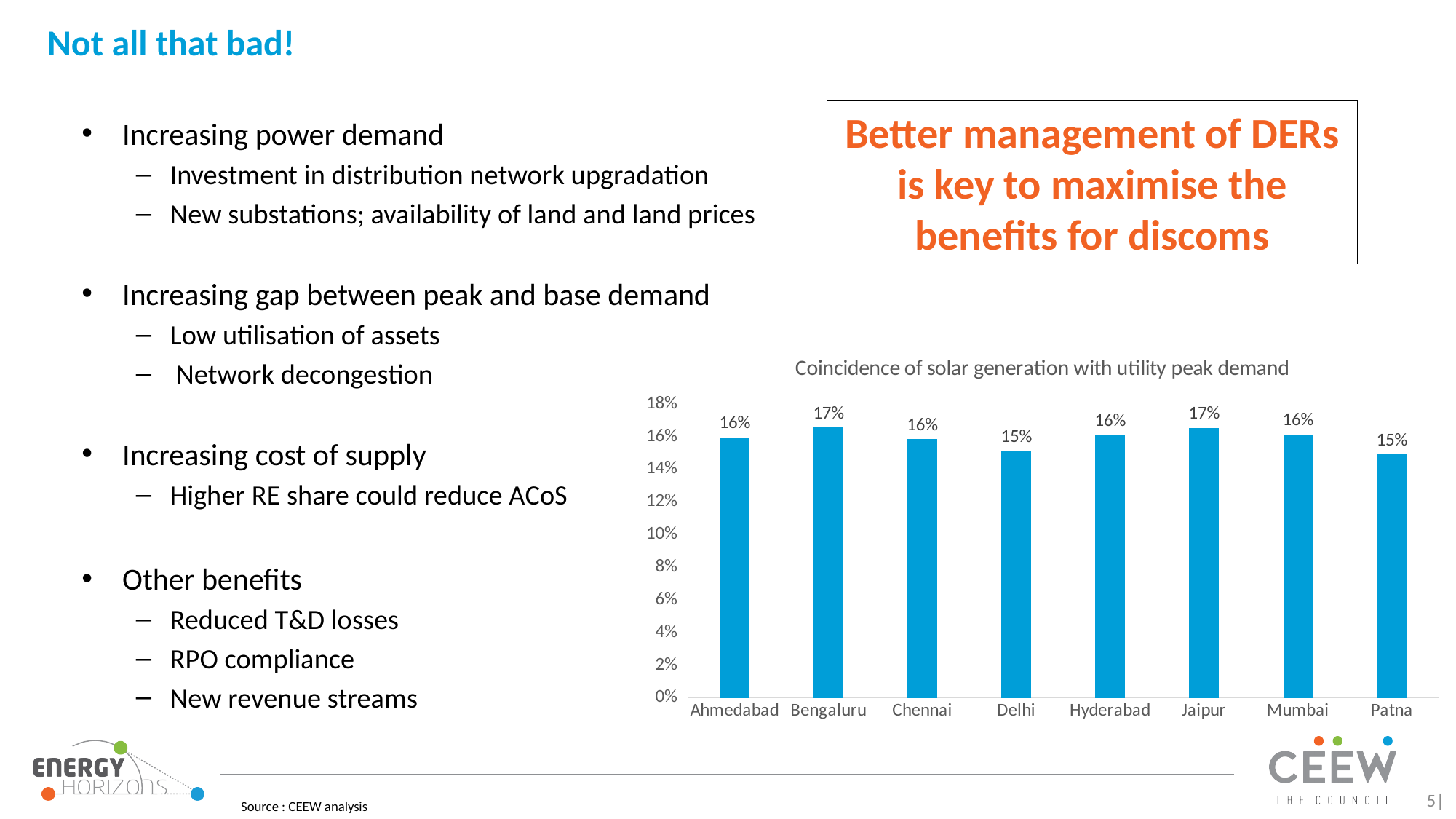
What is the value for Patna in the chart? 15% What kind of chart is shown on the slide? Bar chart What is the value for Jaipur in the chart? 17% What is the value for Ahmedabad in the chart? 16% Is the value for Delhi greater or less than 14%? greater What is the value for Bengaluru in the chart? 17% What is the difference between the values for Jaipur and Patna? 2% Is the value for Patna greater or less than 16%? less What is the value for Delhi in the chart? 15% Which has a higher value, Patna or Jaipur? Jaipur How many cities are shown on the x axis of the chart? 8 Which has a higher value, Bengaluru or Delhi? Bengaluru